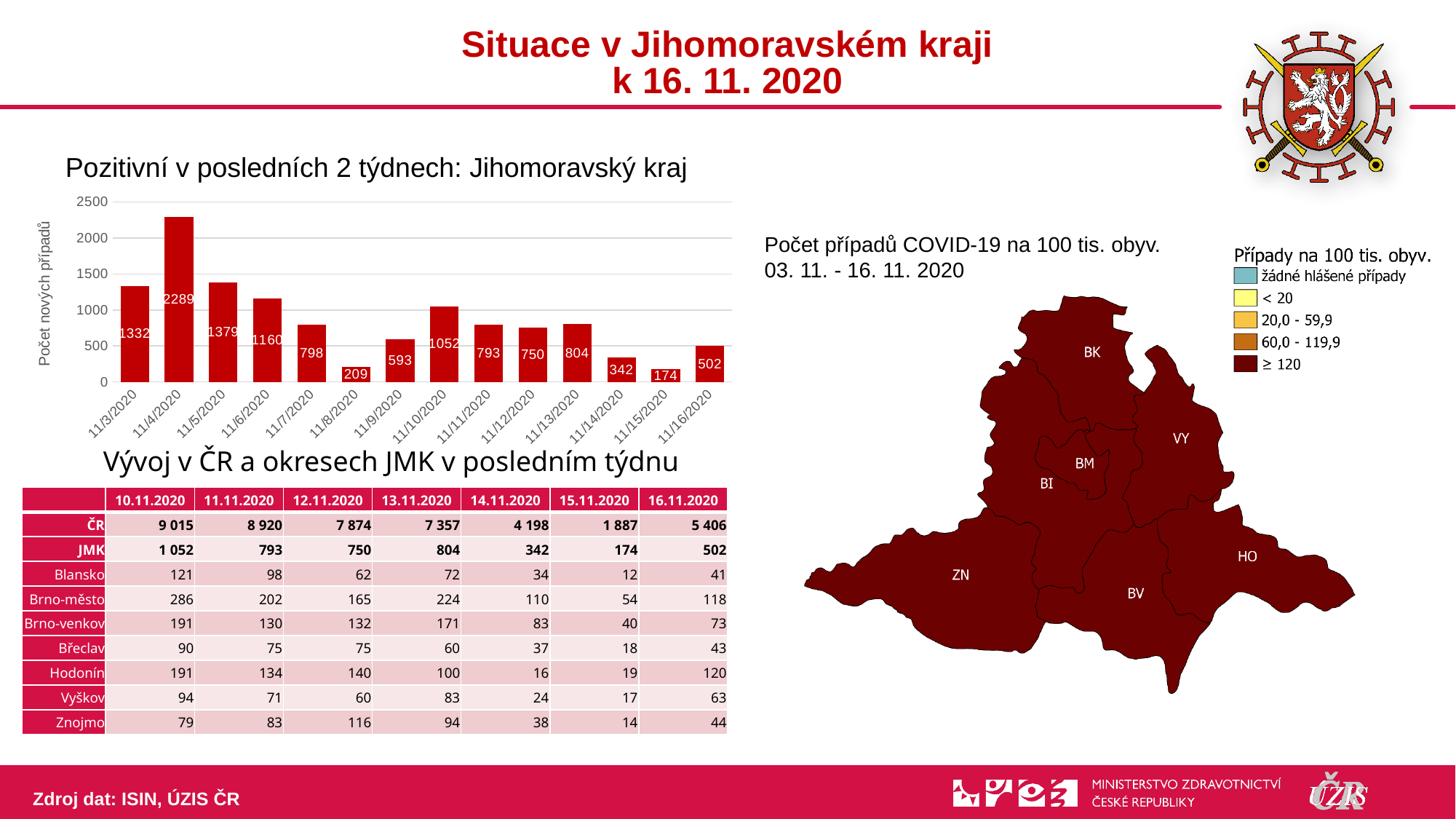
What kind of chart is shown under the title "Pozitivní v posledních 2 týdnech: Jihomoravský kraj"? bar chart In the bar chart, what is the value for 11/4/2020? 2289 Which date has the lowest bar in the bar chart? 11/15/2020 In the bar chart, which is larger: the value for 11/12/2020 or 11/13/2020? 11/13/2020 In the bar chart, what is the value for 11/8/2020? 209 In the bar chart, what is the difference between the values for 11/10/2020 and 11/9/2020? 459 Which date has the highest bar in the bar chart? 11/4/2020 In the bar chart, what is the value for 11/16/2020? 502 In the bar chart, is the value for 11/6/2020 greater or less than 1000? greater How many dates (bars) are shown in the bar chart? 14 What is the label of the vertical axis of the bar chart? Počet nových případů In the bar chart, what is the difference between the values for 11/4/2020 and 11/3/2020? 957